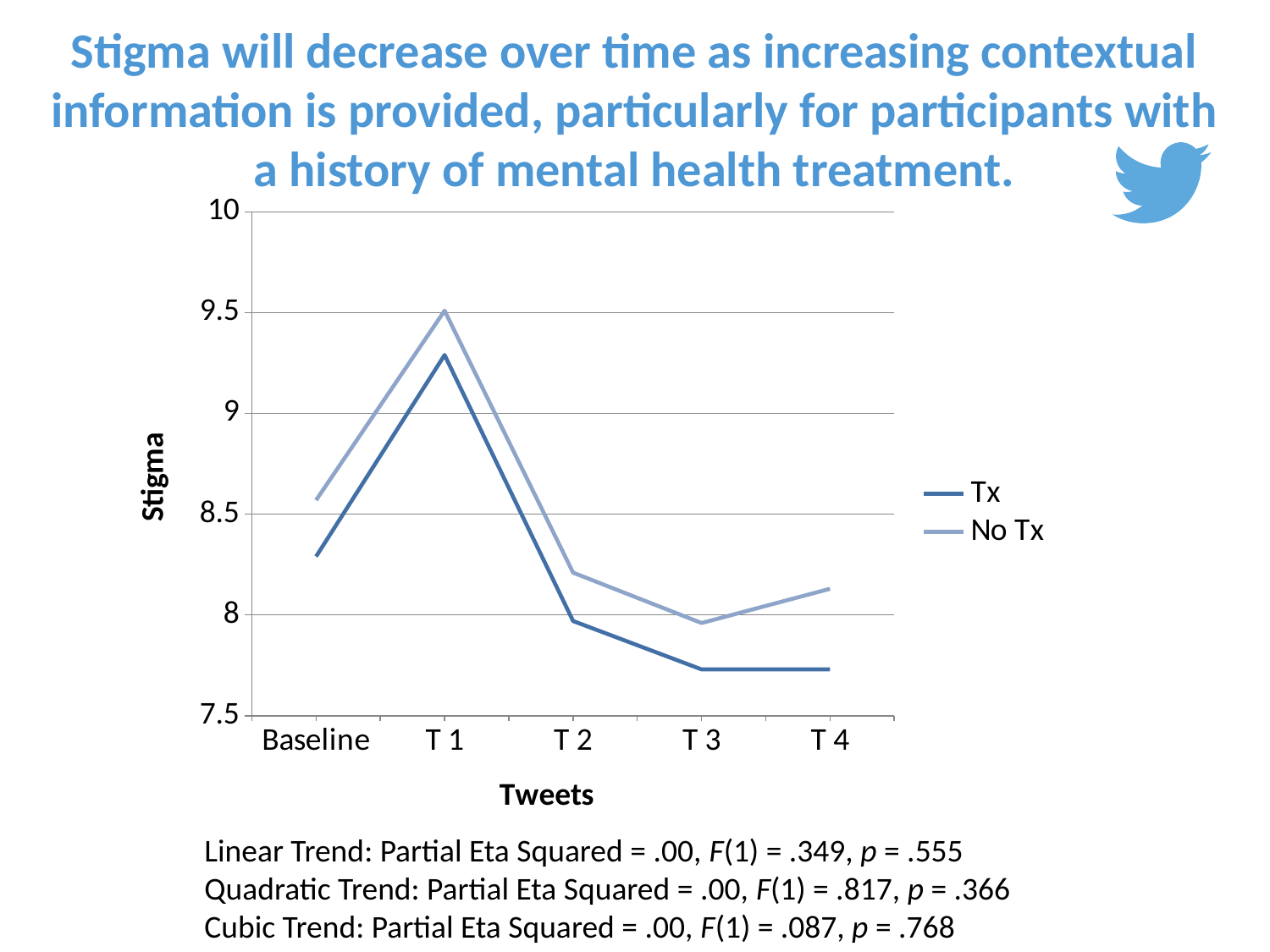
What is the title of the vertical axis? Stigma Is the Tx value at Baseline greater or less than 8.5? less How many series does the legend list? 2 Is the No Tx value at T 4 greater or less than 8? greater At which point on the x axis does the No Tx series reach its lowest value? T 3 At Baseline, which series has the higher Stigma value, Tx or No Tx? No Tx At which point on the x axis does the Tx series reach its highest value? T 1 Does the Tx series rise or fall from T 1 to T 3? fall Is the Tx value at T 1 greater or less than 9? greater What kind of chart is shown on the slide? line chart How many points along the x axis (Tweets) are plotted for each series? 5